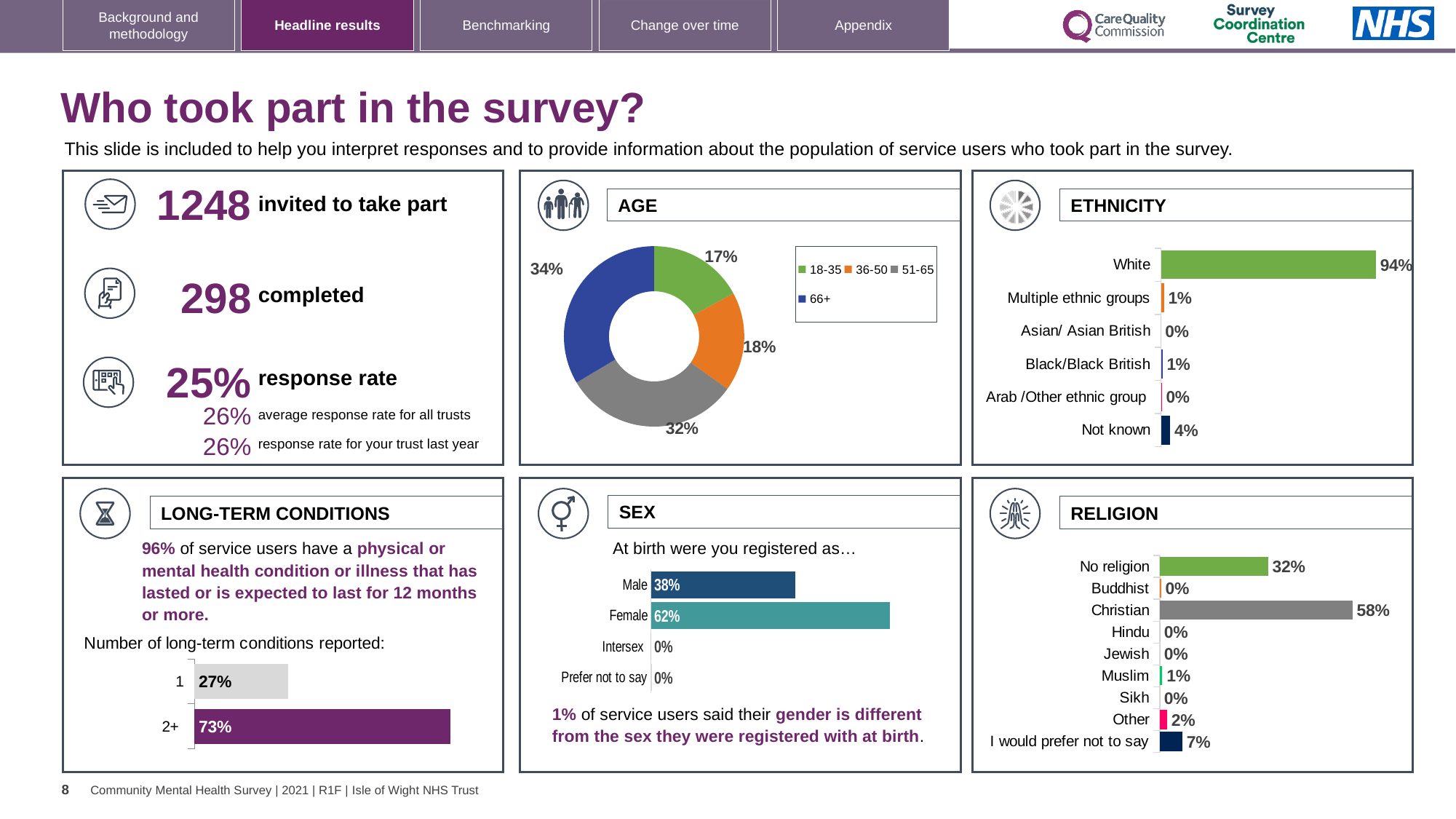
In the ETHNICITY chart, what is the value for White? 94% In the SEX chart, which is larger, Male or Female? Female How many categories are shown in the ETHNICITY chart? 6 In the LONG-TERM CONDITIONS chart, what percentage reported 2+ conditions? 73% In the SEX chart, what is the difference between the Female and Male values? 24% In the AGE chart, what percentage of respondents were aged 66+? 34% How many entries does the legend of the AGE chart list? 4 In the AGE chart, which age group has the smallest share? 18-35 In the RELIGION chart, what is the value for I would prefer not to say? 7% What kind of chart is the AGE chart? Doughnut chart In the RELIGION chart, which category has the highest value? Christian In the ETHNICITY chart, what is the value for Not known? 4%